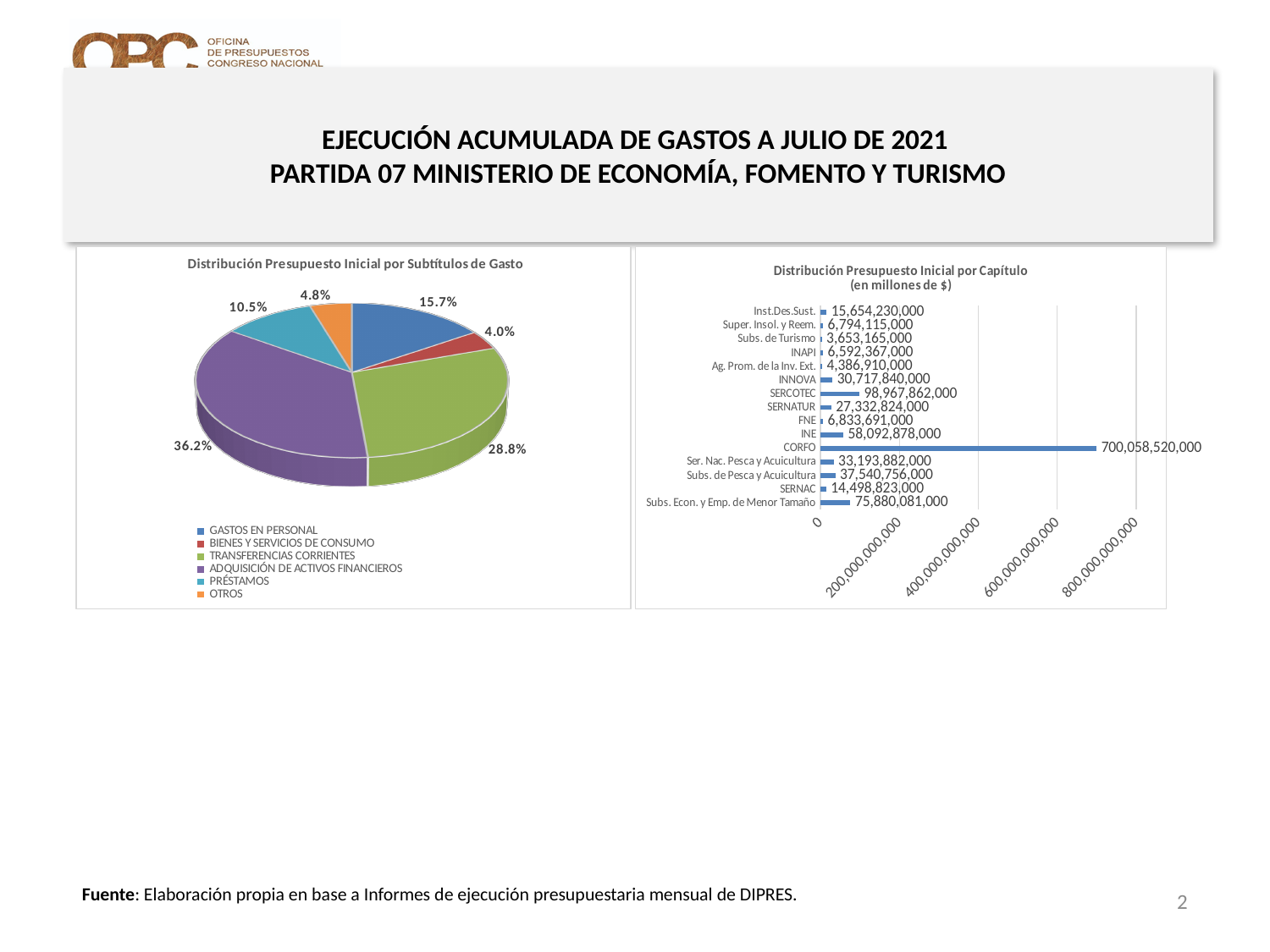
In the pie chart 'Distribución Presupuesto Inicial por Subtítulos de Gasto', how many categories does the legend list? 6 In the bar chart 'Distribución Presupuesto Inicial por Capítulo', how many capítulos are plotted? 15 In the pie chart 'Distribución Presupuesto Inicial por Subtítulos de Gasto', which category has the smallest share? BIENES Y SERVICIOS DE CONSUMO In the pie chart 'Distribución Presupuesto Inicial por Subtítulos de Gasto', what share does ADQUISICIÓN DE ACTIVOS FINANCIEROS have? 36.2% In the bar chart 'Distribución Presupuesto Inicial por Capítulo', what is the value for SERCOTEC? 98,967,862,000 In the bar chart 'Distribución Presupuesto Inicial por Capítulo', what is the value for CORFO? 700,058,520,000 In the pie chart 'Distribución Presupuesto Inicial por Subtítulos de Gasto', what share does GASTOS EN PERSONAL have? 15.7% In the bar chart 'Distribución Presupuesto Inicial por Capítulo', which capítulo has the lowest value? Subs. de Turismo In the bar chart 'Distribución Presupuesto Inicial por Capítulo', is the value for CORFO greater or less than 600,000,000,000? greater What type of chart is 'Distribución Presupuesto Inicial por Capítulo'? Bar chart In the bar chart 'Distribución Presupuesto Inicial por Capítulo', which is larger, INE or INNOVA? INE In the pie chart 'Distribución Presupuesto Inicial por Subtítulos de Gasto', what is the difference between the shares of TRANSFERENCIAS CORRIENTES and PRÉSTAMOS? 18.3%